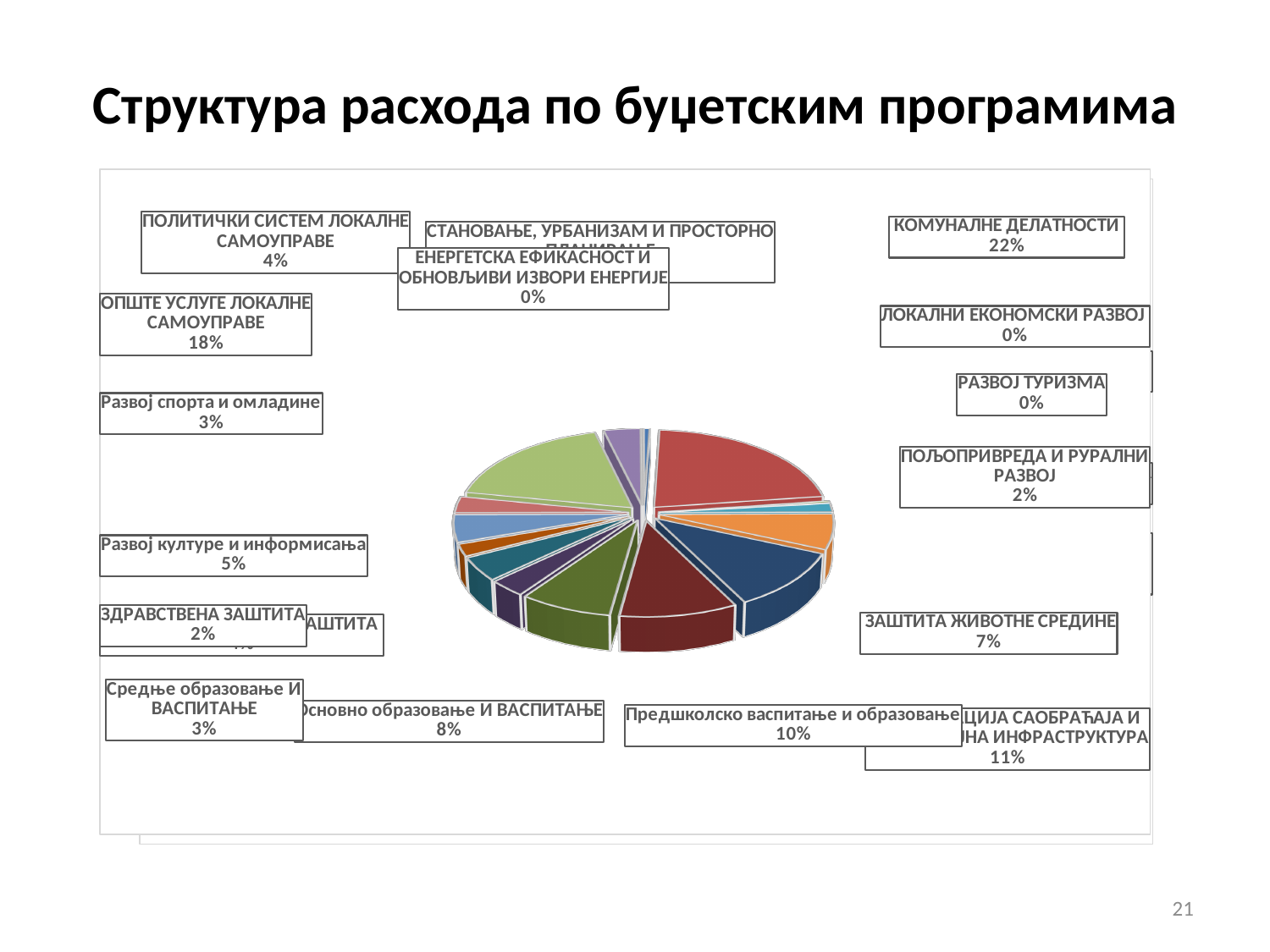
What is the difference in percentage points between КОМУНАЛНЕ ДЕЛАТНОСТИ and ОПШТЕ УСЛУГЕ ЛОКАЛНЕ САМОУПРАВЕ? 4 percentage points What share is shown for Развој културе и информисања? 5% What share of expenditure goes to ОПШТЕ УСЛУГЕ ЛОКАЛНЕ САМОУПРАВЕ? 18% What is the title of the chart on the slide? Структура расхода по буџетским програмима What share is shown for Предшколско васпитање и образовање? 10% What share of expenditure goes to КОМУНАЛНЕ ДЕЛАТНОСТИ? 22% Which has the larger share: Основно образовање И ВАСПИТАЊЕ or Средње образовање И ВАСПИТАЊЕ? Основно образовање И ВАСПИТАЊЕ What kind of chart is shown on the slide? pie chart What share is shown for Основно образовање И ВАСПИТАЊЕ? 8% Which budget programme has the largest share of expenditure? КОМУНАЛНЕ ДЕЛАТНОСТИ What share is shown for ПОЉОПРИВРЕДА И РУРАЛНИ РАЗВОЈ? 2% What share is shown for ЗАШТИТА ЖИВОТНЕ СРЕДИНЕ? 7%